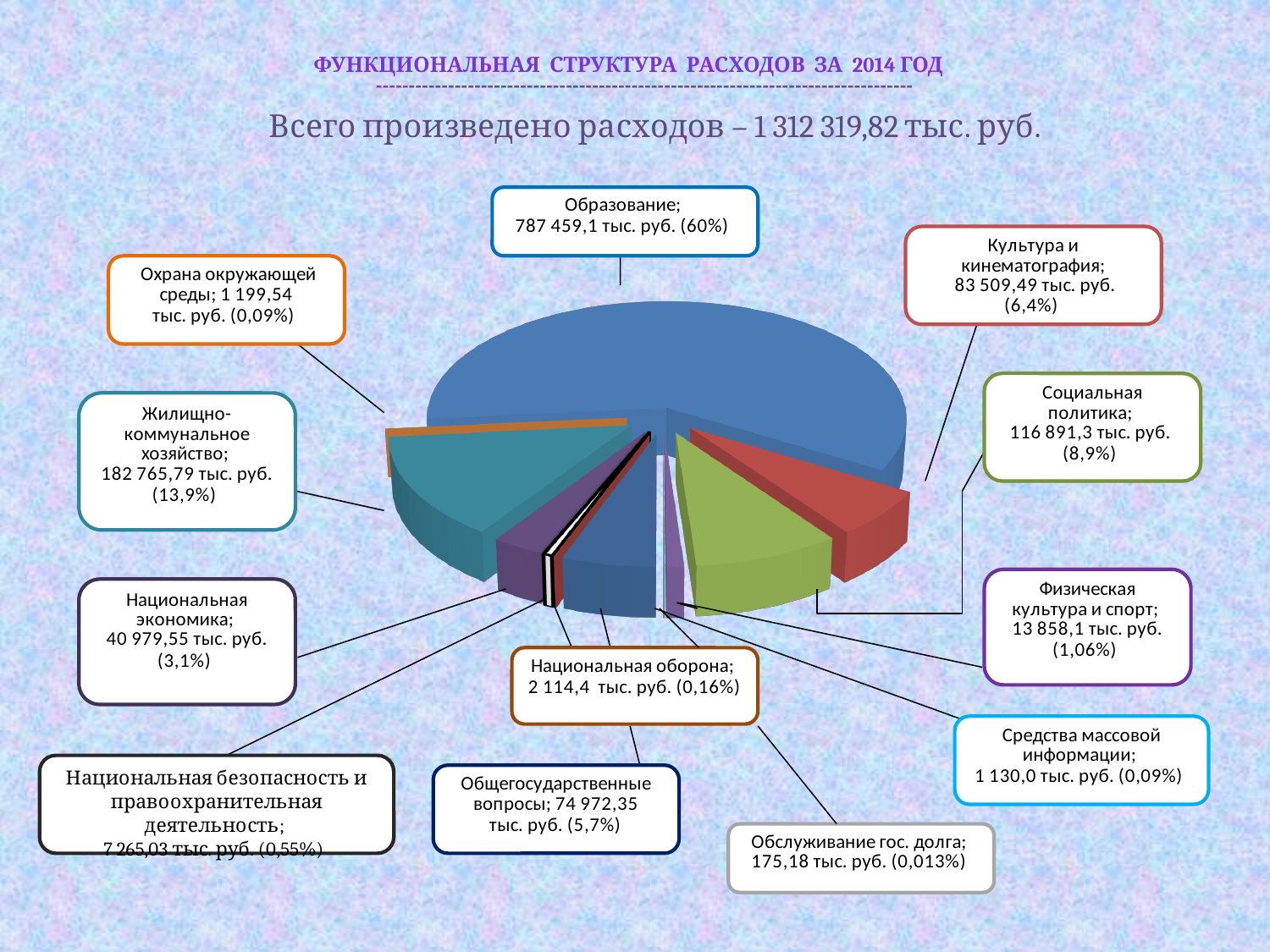
Which category has the smallest share of expenditures? Обслуживание гос. долга What percentage is shown for Физическая культура и спорт? 1,06% Which category has the largest share of expenditures? Образование What is the difference between Социальная политика and Культура и кинематография in тыс. руб.? 33 381,81 тыс. руб. What is the value for Социальная политика? 116 891,3 тыс. руб. What kind of chart is shown on the slide? Pie chart What total expenditure amount is stated above the chart? 1 312 319,82 тыс. руб. What share of the pie does Жилищно-коммунальное хозяйство represent? 13,9% What is the value for Национальная оборона? 2 114,4 тыс. руб. What is the value for Образование? 787 459,1 тыс. руб. How many categories (slices) does the pie chart have? 12 Which is larger: Культура и кинематография or Общегосударственные вопросы? Культура и кинематография